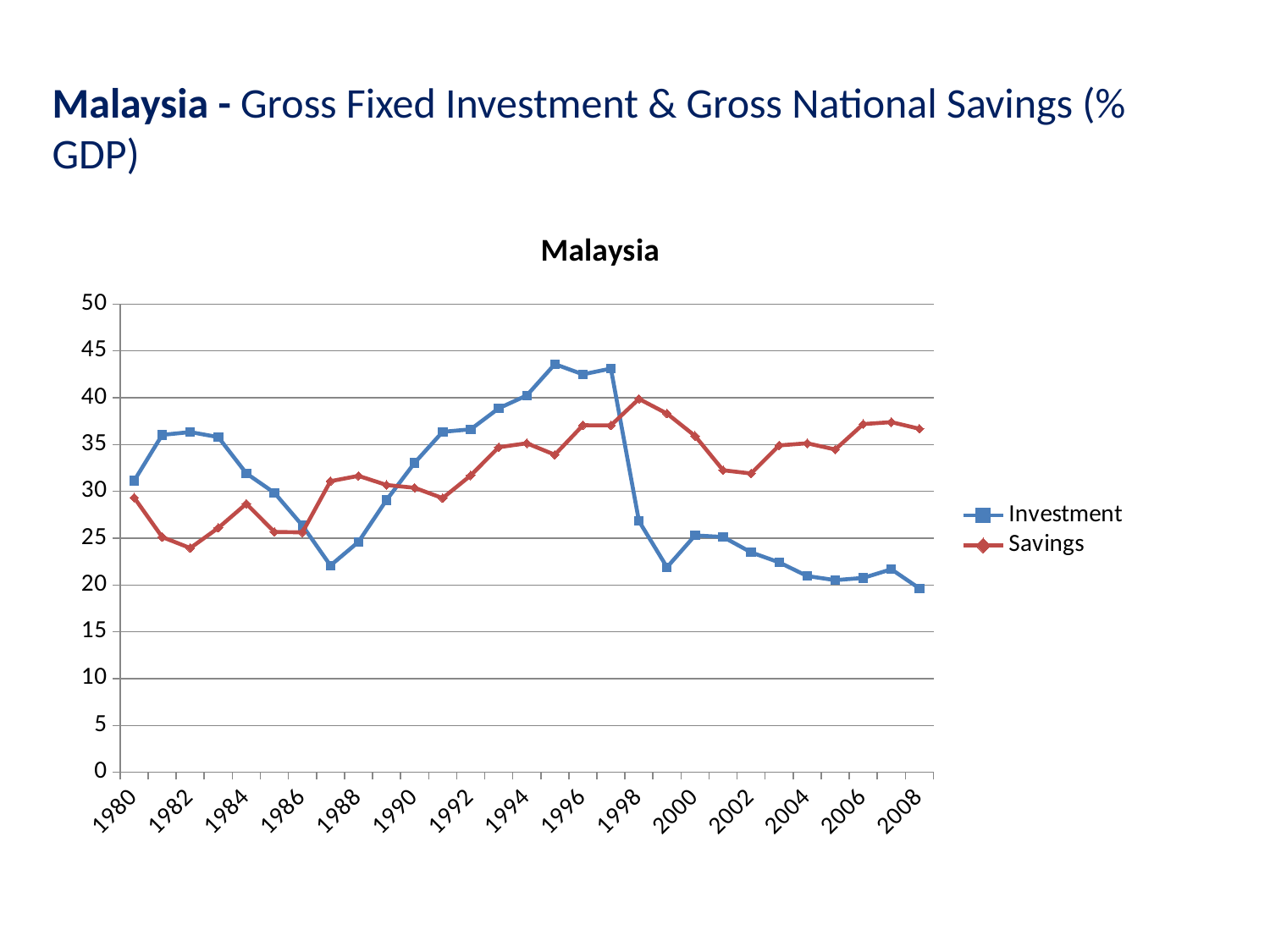
Is the Savings value for 2006 greater or less than 35? greater Does the Investment series rise or fall overall from 1998 to 2008? Fall Is the Investment value for 1982 greater or less than 35? greater How many series does the legend list? 2 Is the Investment value for 2004 greater or less than 25? less What kind of chart is shown on the slide? Line chart Which series is drawn in red? Savings In 2000, which is larger, Investment or Savings? Savings In 1996, which is larger, Investment or Savings? Investment What is the title of the chart? Malaysia